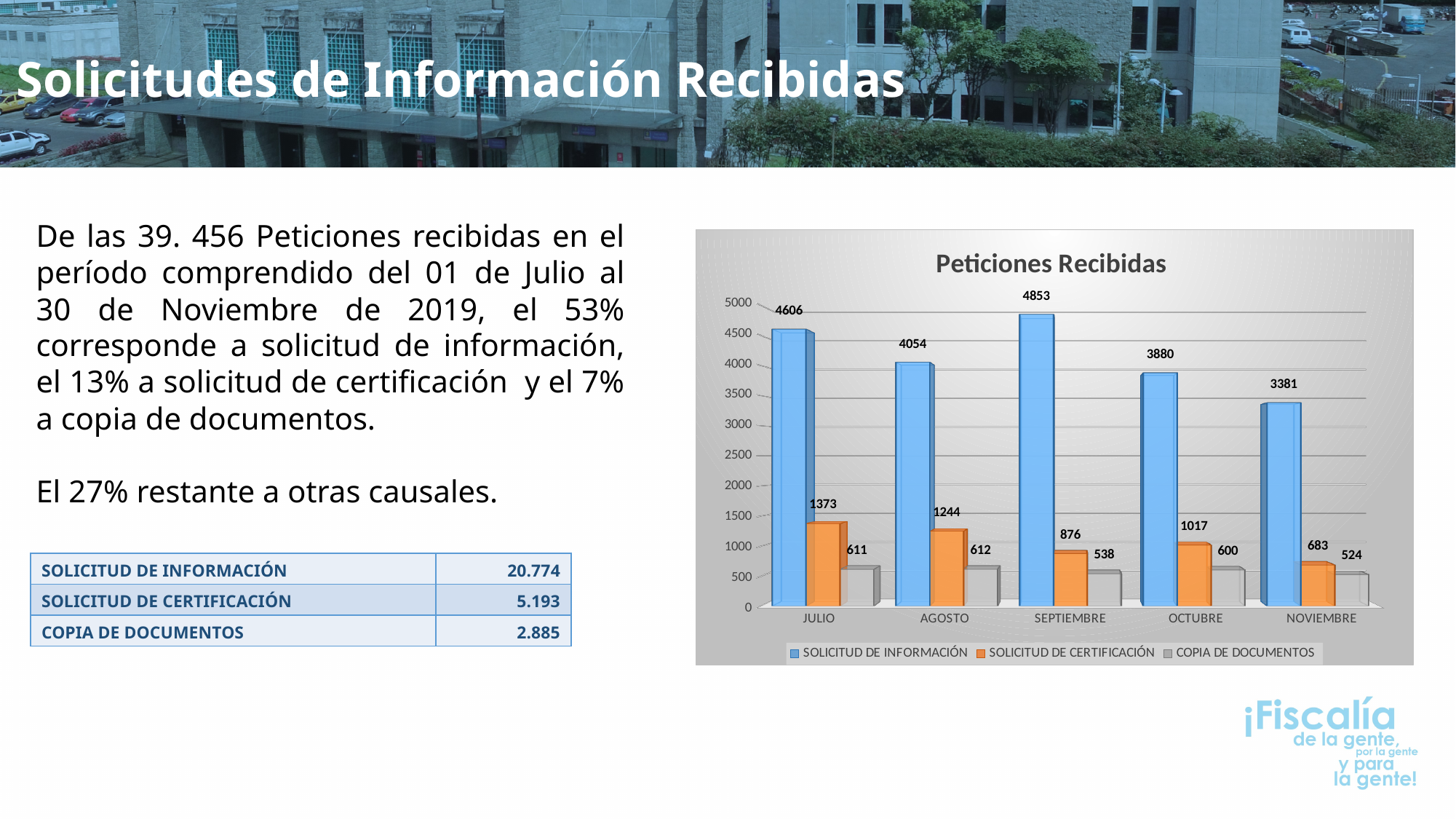
What is the difference between SOLICITUD DE INFORMACIÓN in JULIO and in AGOSTO? 552 What is the value for COPIA DE DOCUMENTOS in NOVIEMBRE? 524 How many series does the chart legend list? 3 In which month is SOLICITUD DE CERTIFICACIÓN lowest? NOVIEMBRE What is the title of the chart? Peticiones Recibidas What kind of chart is shown on the slide? bar chart What is the value for SOLICITUD DE CERTIFICACIÓN in JULIO? 1373 Which is larger: SOLICITUD DE CERTIFICACIÓN in OCTUBRE or in SEPTIEMBRE? OCTUBRE In which month is SOLICITUD DE INFORMACIÓN highest? SEPTIEMBRE Is the value for SOLICITUD DE INFORMACIÓN in NOVIEMBRE greater or less than 3500? less What is the value for SOLICITUD DE INFORMACIÓN in SEPTIEMBRE? 4853 How many months are shown on the x axis of the chart? 5